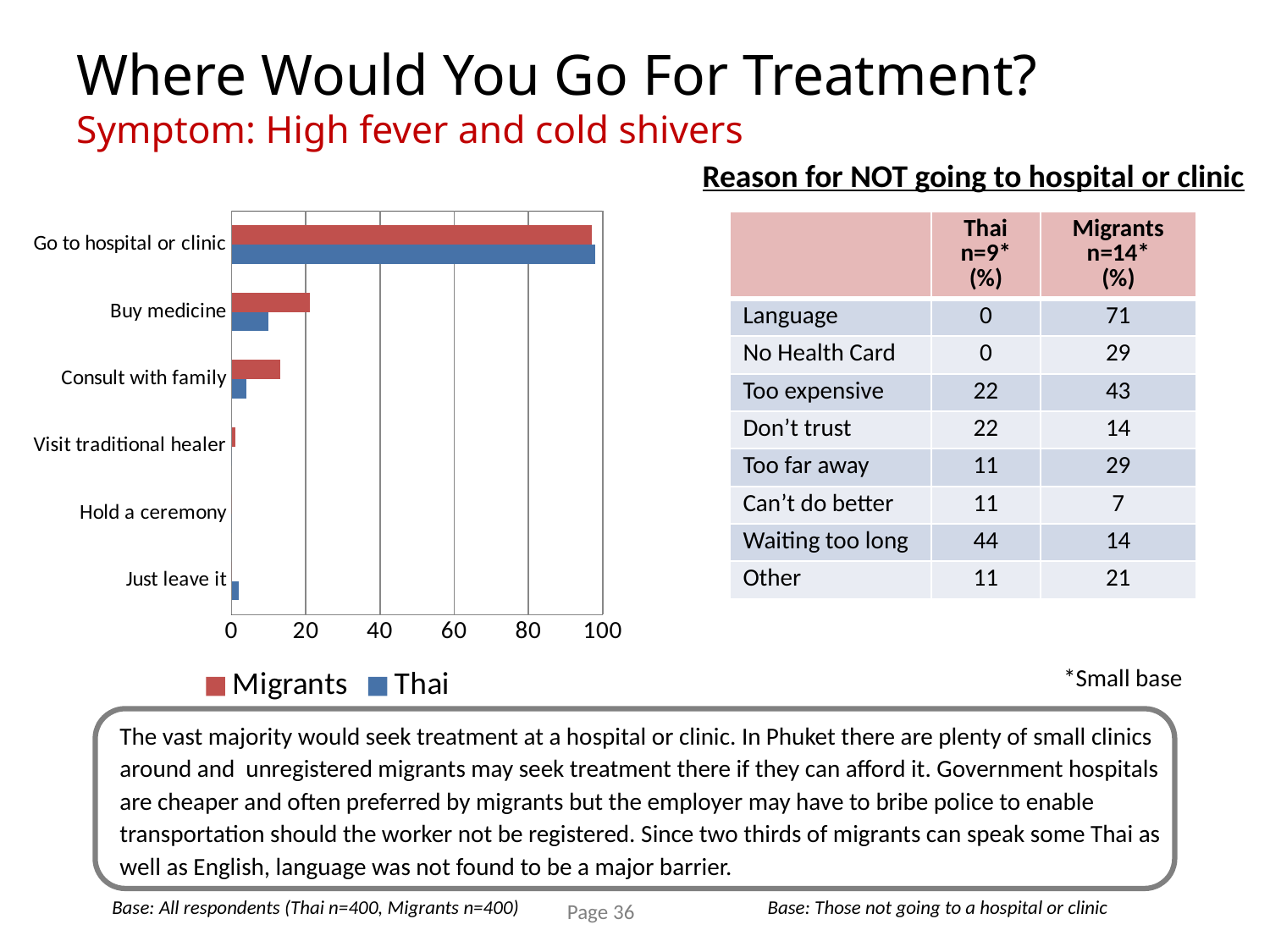
For Buy medicine, which series has the larger value, Migrants or Thai? Migrants Which treatment option has the highest value for Migrants? Go to hospital or clinic What are the two series named in the chart legend? Migrants and Thai Is the Migrants value for Consult with family greater or less than 20? less What colour represents Migrants in the chart? red Which treatment option has the highest value for Thai? Go to hospital or clinic Is the Migrants value for Go to hospital or clinic greater or less than 80? greater How many series does the chart legend list? 2 What kind of chart is shown on the left of the slide? bar chart For Consult with family, which series has the larger value, Migrants or Thai? Migrants How many treatment options (categories) are plotted on the chart? 6 Is the Thai value for Buy medicine greater or less than 20? less